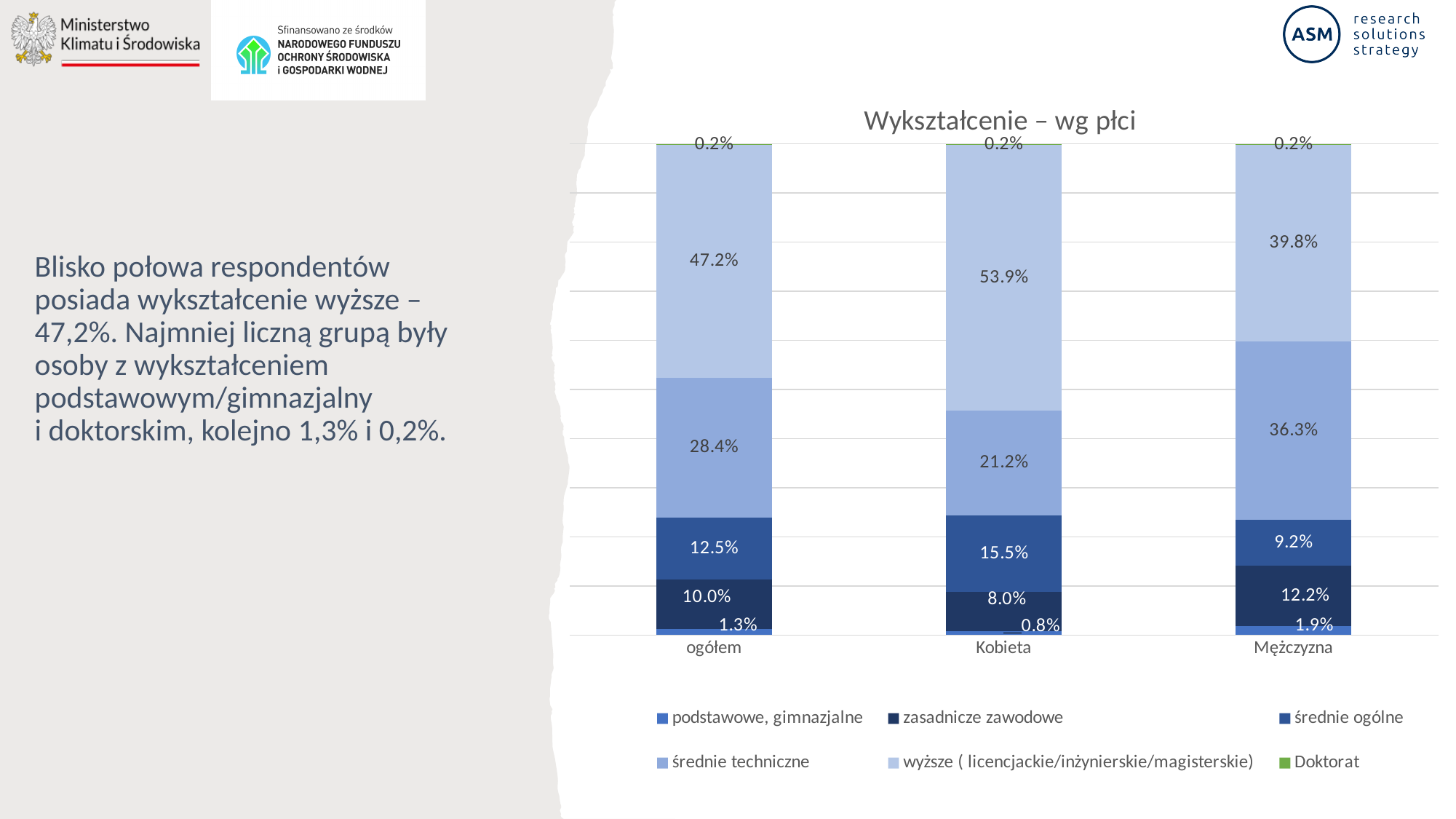
What kind of chart is shown on the slide? Stacked bar chart What is the title of the chart? Wykształcenie – wg płci What is the value for 'średnie techniczne' in the 'Mężczyzna' bar? 36.3% Which is larger: the 'zasadnicze zawodowe' value for 'Mężczyzna' or for 'Kobieta'? Mężczyzna What is the value for 'zasadnicze zawodowe' in the 'ogółem' bar? 10.0% How many categories are shown on the x axis? 3 Which category has the highest value for 'wyższe ( licencjackie/inżynierskie/magisterskie)'? Kobieta Which category has the lowest value for 'średnie ogólne'? Mężczyzna How many series does the legend list? 6 What is the value for 'podstawowe, gimnazjalne' in the 'Kobieta' bar? 0.8% What is the difference between the 'średnie techniczne' values for 'Mężczyzna' and 'Kobieta'? 15.1% What is the value for 'wyższe ( licencjackie/inżynierskie/magisterskie)' in the 'Kobieta' bar? 53.9%